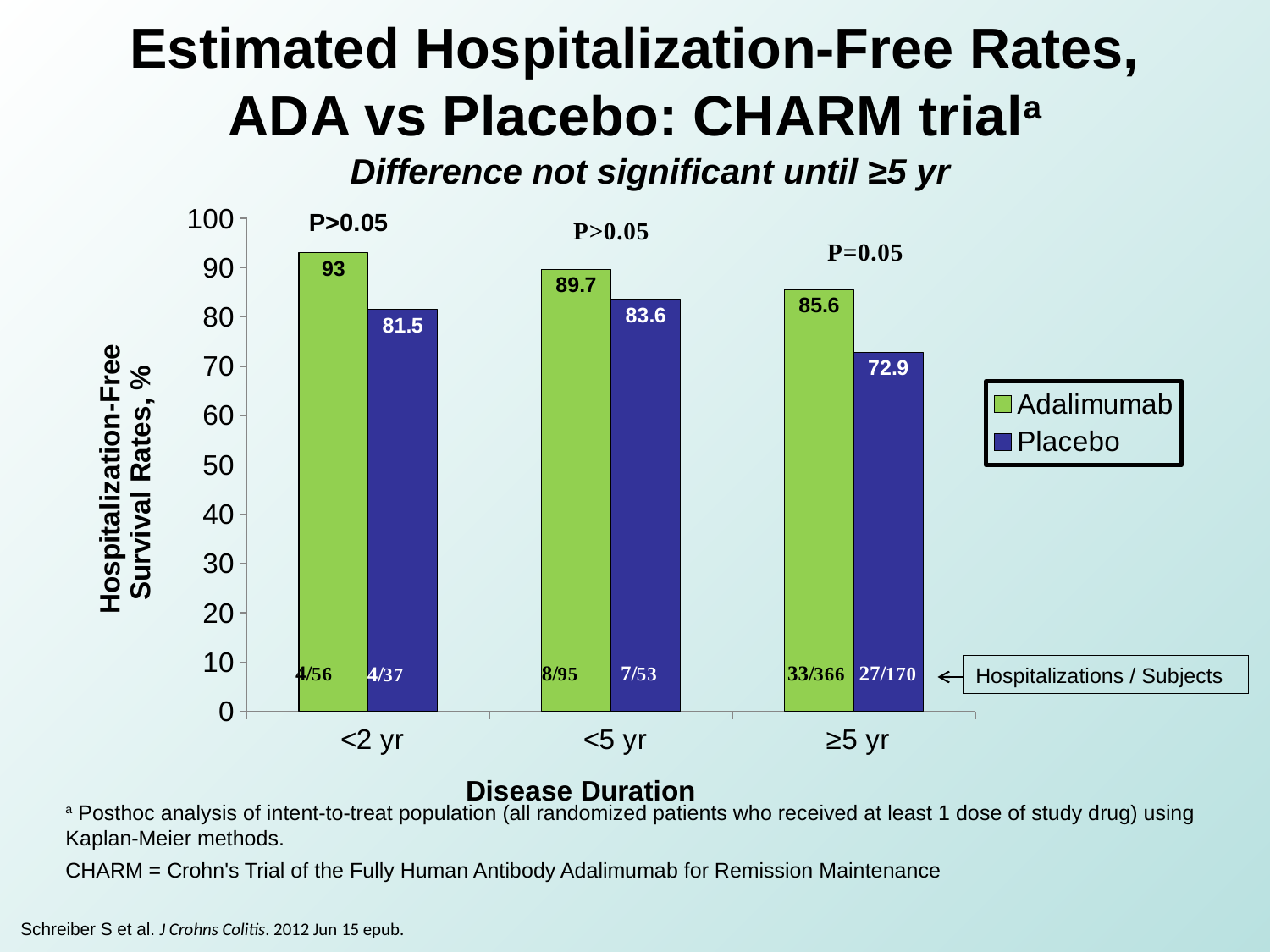
What is the hospitalization-free survival rate for Placebo in the ≥5 yr disease duration group? 72.9 Which disease duration group has the lowest Placebo hospitalization-free survival rate? ≥5 yr What kind of chart is shown on the slide? Bar chart What is the hospitalization-free survival rate for Placebo in the <5 yr disease duration group? 83.6 How many disease duration categories are shown on the x axis? 3 Do the Adalimumab hospitalization-free survival rates rise or fall as disease duration increases along the x axis? Fall Is the Placebo value for the ≥5 yr group greater or less than 80? less What is the hospitalization-free survival rate for Adalimumab in the <2 yr disease duration group? 93 In the <2 yr group, which has the higher hospitalization-free survival rate, Adalimumab or Placebo? Adalimumab What is the difference between the Adalimumab and Placebo hospitalization-free survival rates in the ≥5 yr group? 12.7 Which disease duration group has the highest Adalimumab hospitalization-free survival rate? <2 yr How many series does the legend list? 2